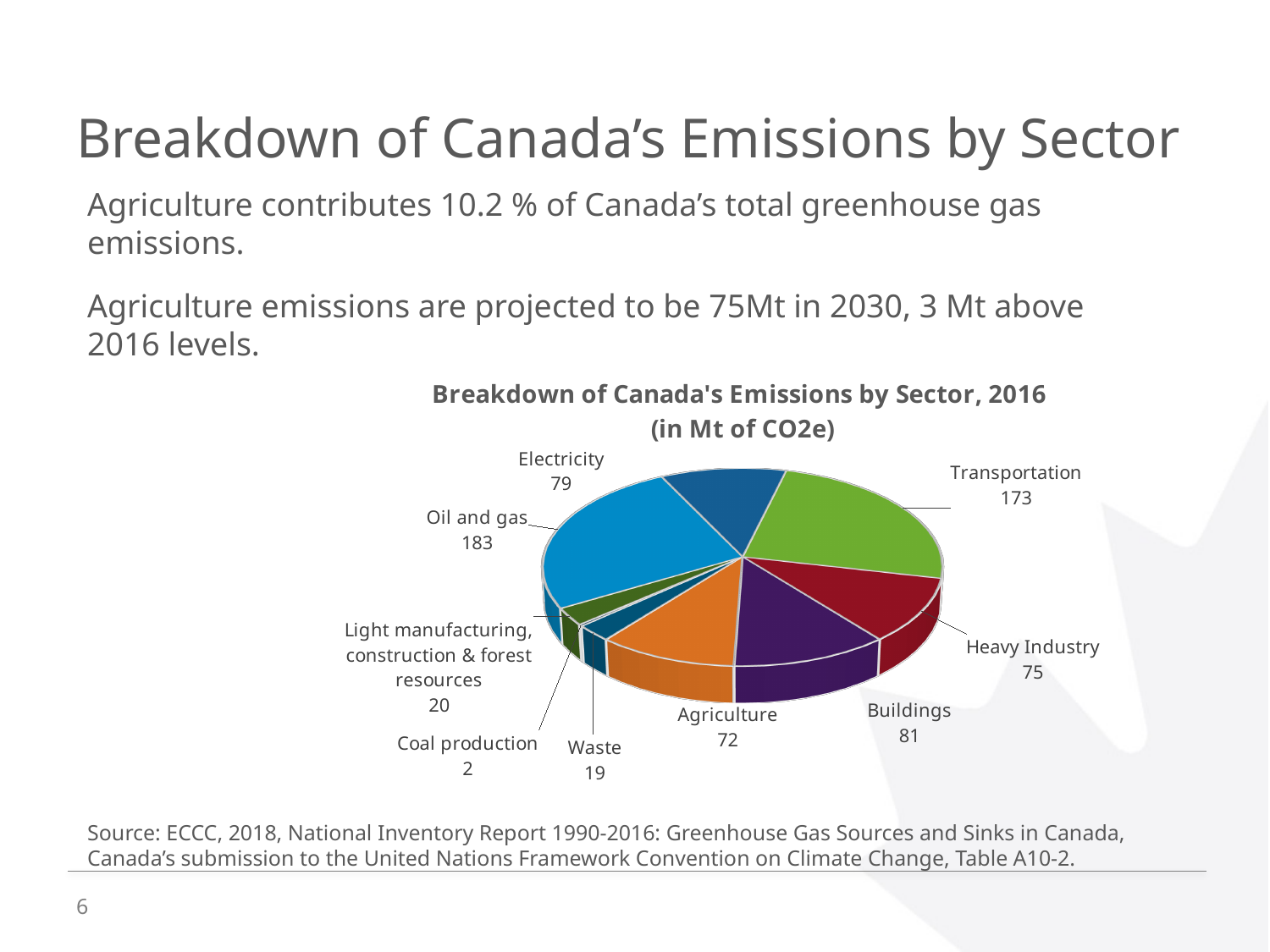
What is the value for Oil and gas in the pie chart? 183 What is the title of the pie chart? Breakdown of Canada's Emissions by Sector, 2016 (in Mt of CO2e) What type of chart is shown on the slide? Pie chart Which sector has the smallest slice in the pie chart? Coal production What is the value for Waste in the pie chart? 19 Which sector has the largest slice in the pie chart? Oil and gas What is the difference between the values for Oil and gas and Transportation? 10 What is the difference between the values for Buildings and Heavy Industry? 6 Which is larger, Electricity or Heavy Industry? Electricity How many sectors are shown in the pie chart? 9 What is the value for Agriculture in the pie chart? 72 What share of the total does Agriculture represent in the pie chart? 10.2%